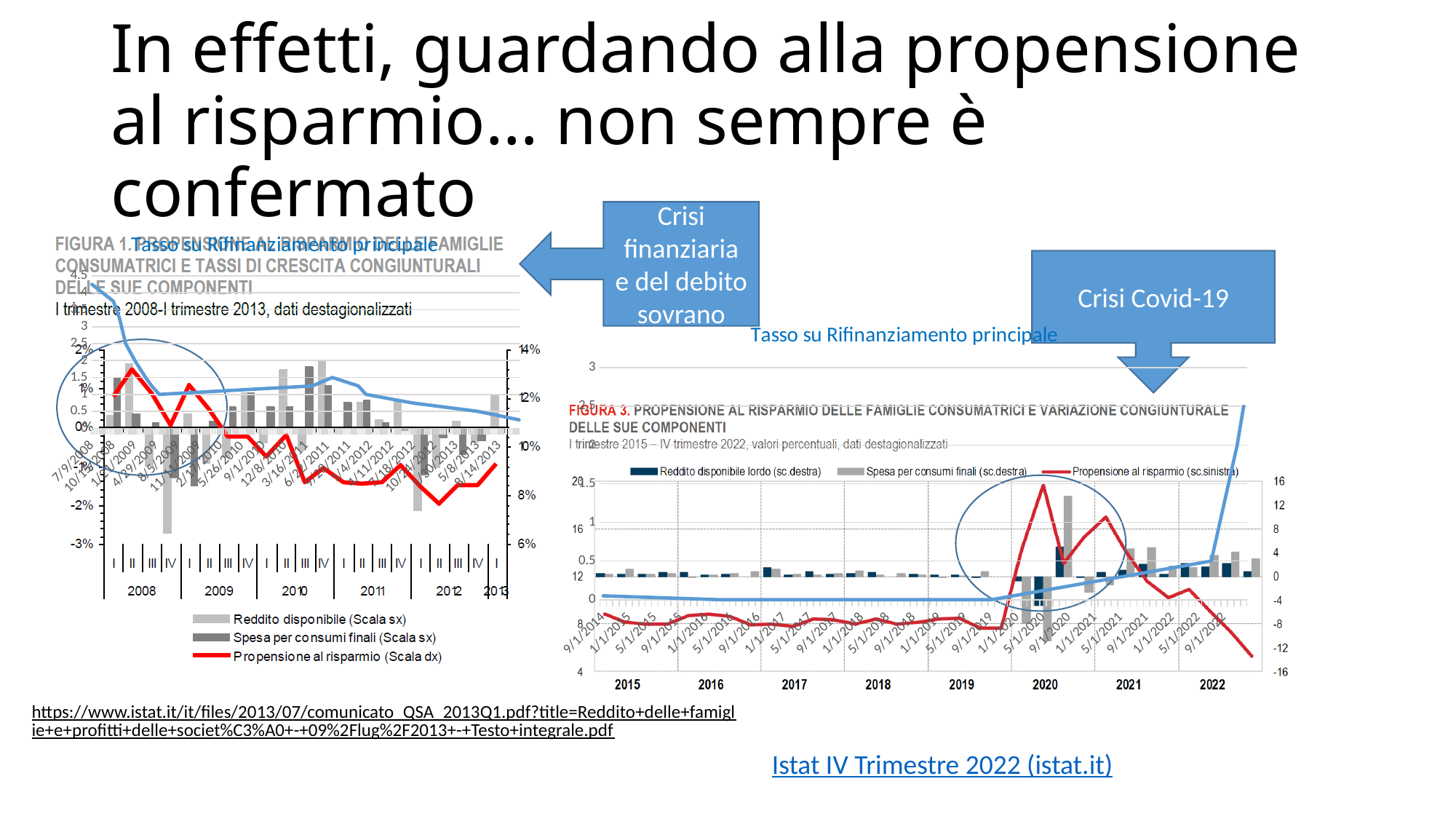
What kind of chart is the 'Tasso su Rifinanziamento principale' chart on the left side of the slide? line chart In the right 'Tasso su Rifinanziamento principale' chart, is the value at 9/1/2022 greater or less than 2? less In Figura 3 (right Istat chart), what colour is the 'Propensione al risparmio' line? red In the left 'Tasso su Rifinanziamento principale' chart, which is larger: the value at 7/9/2008 or the value at 9/14/2013? 7/9/2008 In the left 'Tasso su Rifinanziamento principale' chart, is the value at 7/9/2008 greater or less than 3? greater In the right 'Tasso su Rifinanziamento principale' chart, which is larger: the value at 9/1/2014 or the value at 9/1/2022? 9/1/2022 In the right 'Tasso su Rifinanziamento principale' chart, do the values rise or fall overall from 9/1/2014 to 9/1/2022? rise How many series does the legend of Figura 1 (left Istat chart) list? 3 In Figura 3 (right Istat chart), in which year does the 'Propensione al risparmio' line reach its highest value? 2020 In the left 'Tasso su Rifinanziamento principale' chart, do the values rise or fall overall from 7/9/2008 to 9/14/2013? fall How many series does the legend of Figura 3 (right Istat chart) list? 3 In the left 'Tasso su Rifinanziamento principale' chart, is the value at 9/14/2013 greater or less than 1? less